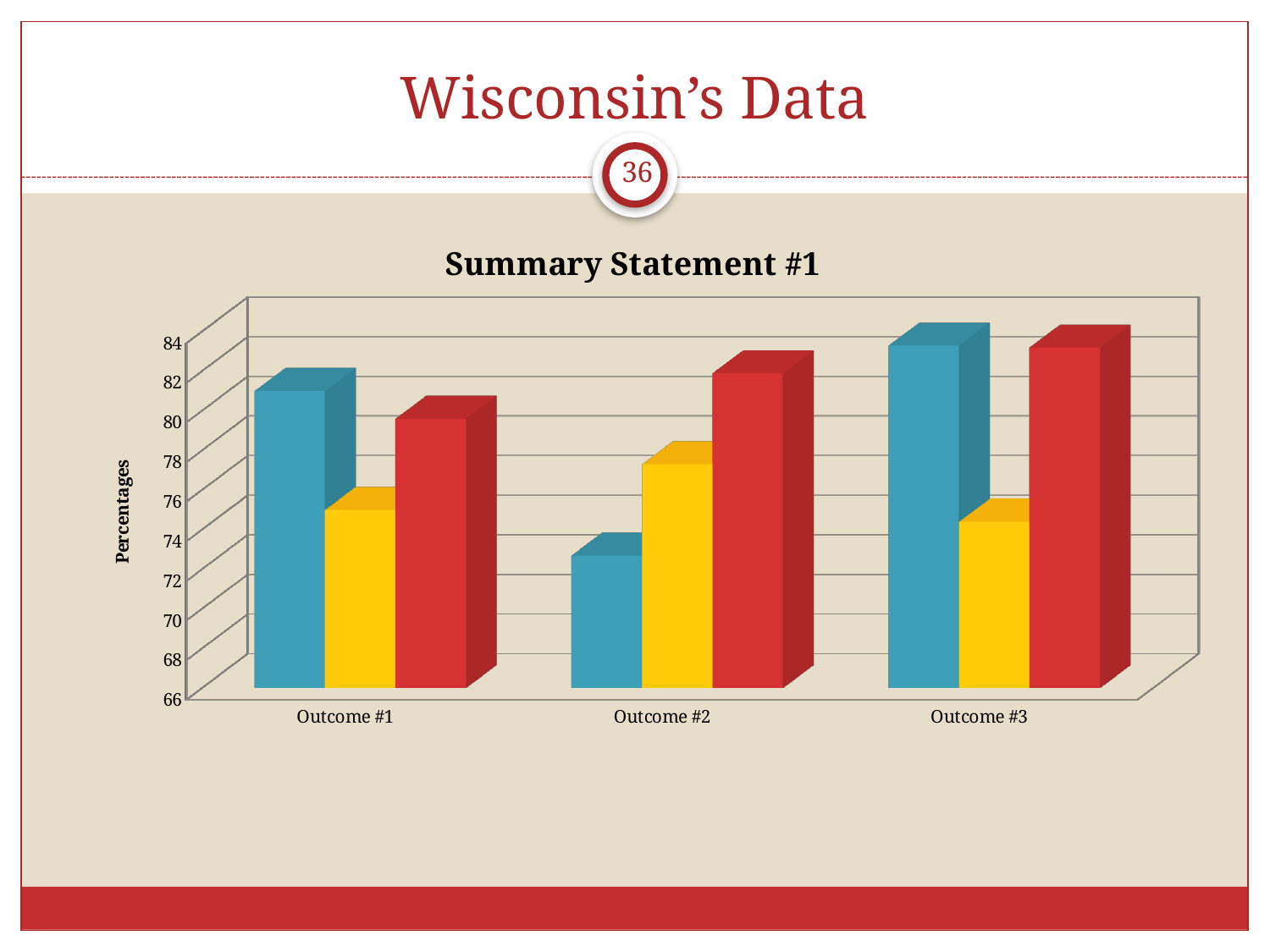
What is the label on the vertical axis of the chart? Percentages Among the blue bars, which outcome has the lowest value? Outcome #2 Is the value of the blue bar for Outcome #2 greater or less than 76? less How many outcome categories are shown on the x axis of the chart? 3 For Outcome #2, which is larger: the red bar or the blue bar? the red bar Is the value of the yellow bar for Outcome #1 greater or less than 78? less Among the yellow bars, which outcome has the highest value? Outcome #2 What kind of chart is shown under the title "Summary Statement #1"? bar chart Is the value of the red bar for Outcome #2 greater or less than 80? greater What is the title of the chart on the slide? Summary Statement #1 For Outcome #1, which is larger: the blue bar or the yellow bar? the blue bar